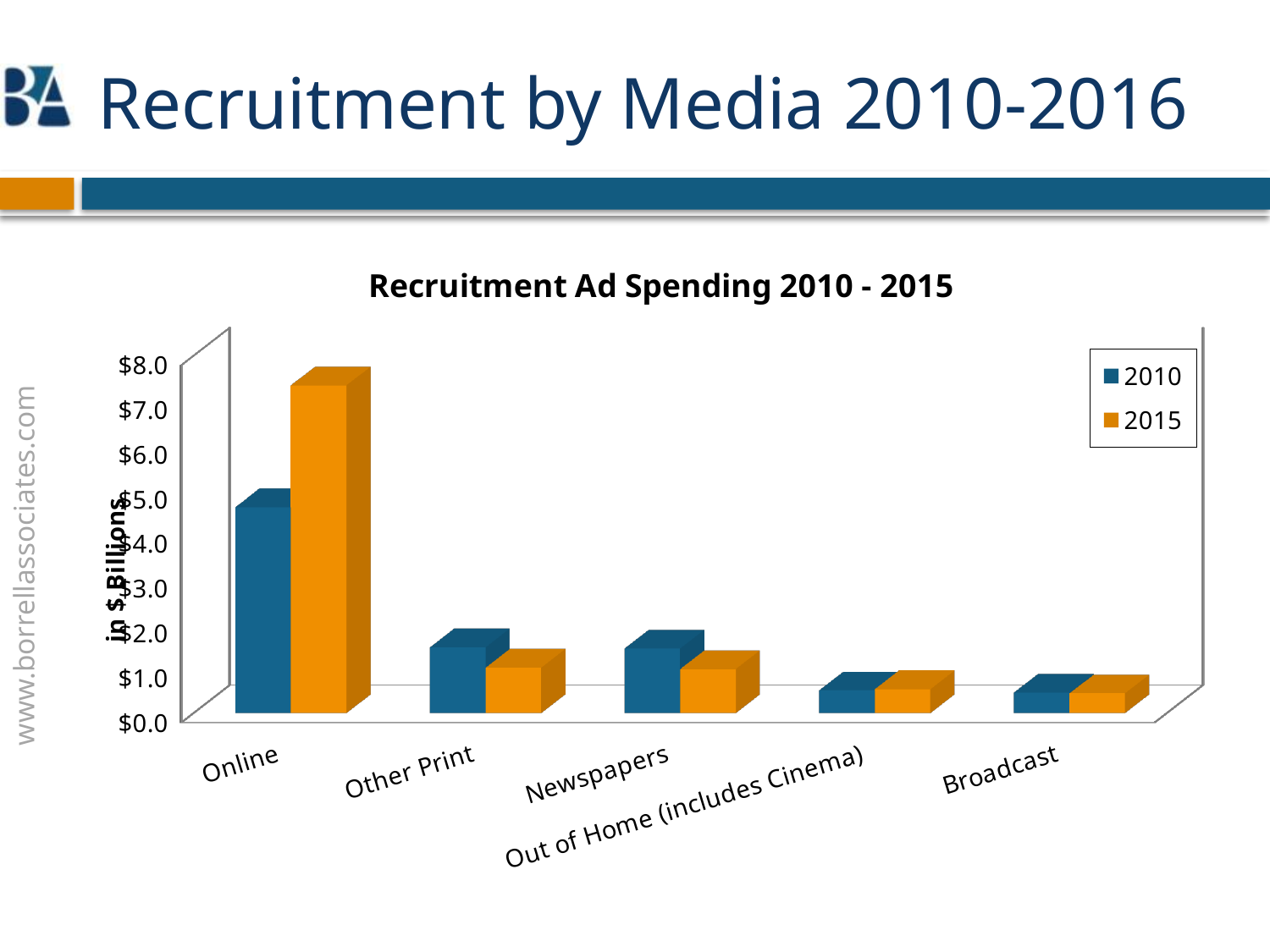
What is the title of the chart? Recruitment Ad Spending 2010 - 2015 Is the 2010 value for Other Print greater or less than $2.0? less How many media categories are shown on the x axis of the chart? 5 Is the 2010 value for Broadcast greater or less than $1.0? less Which category has the highest 2015 recruitment ad spending? Online For Online, which year has the larger value, 2010 or 2015? 2015 Which category has the highest 2010 recruitment ad spending? Online What kind of chart is shown on the slide? bar chart How many series does the chart's legend list? 2 Is the 2010 value for Online greater or less than $4.0? greater For Other Print, which year has the larger value, 2010 or 2015? 2010